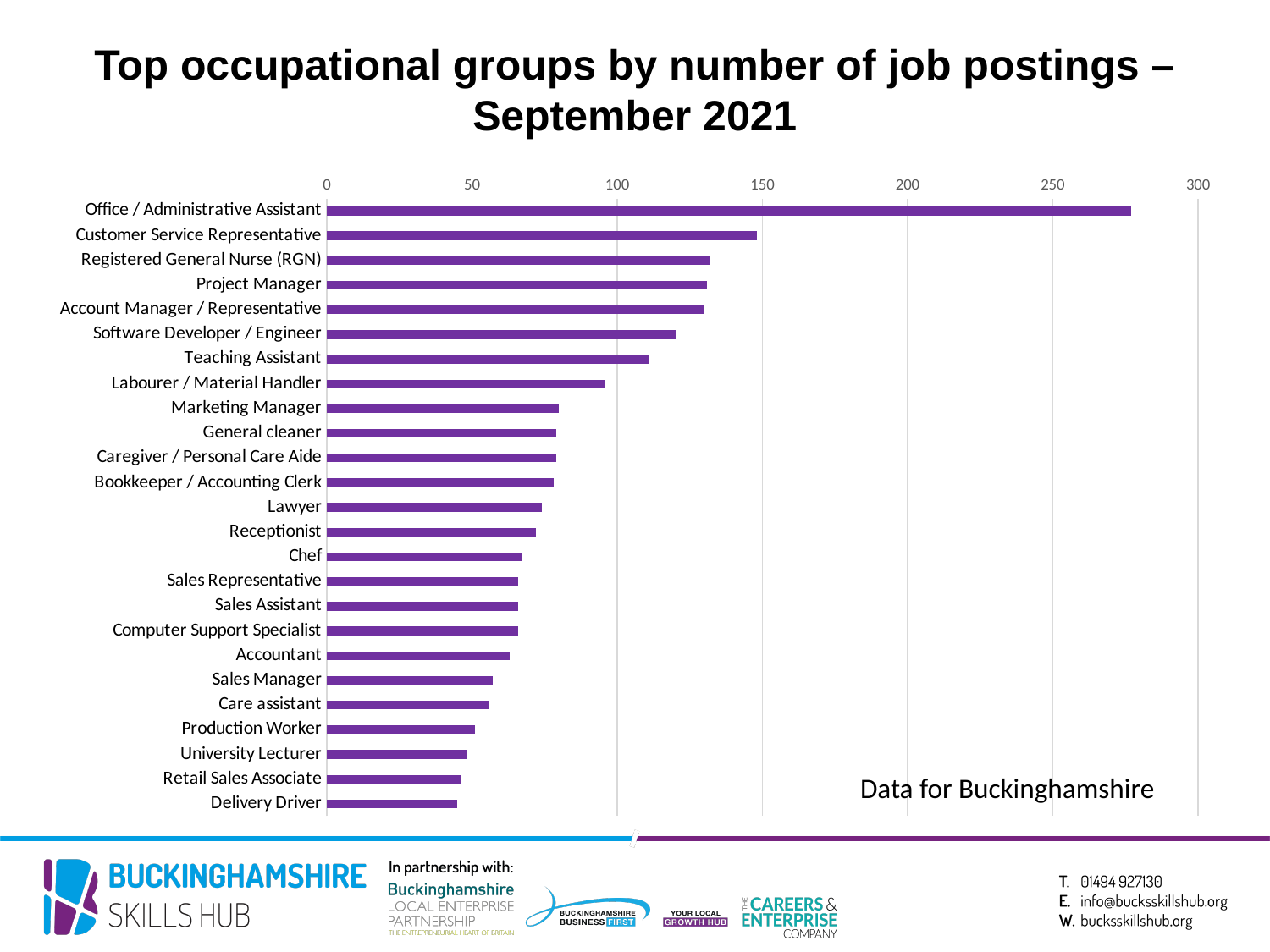
Is the value for Labourer / Material Handler greater or less than 100? less What kind of chart is shown on the slide? Bar chart Is the value for Delivery Driver greater or less than 50? less Which has more job postings, Teaching Assistant or Labourer / Material Handler? Teaching Assistant What is the title of the chart? Top occupational groups by number of job postings – September 2021 Which has more job postings, Office / Administrative Assistant or Customer Service Representative? Office / Administrative Assistant Which occupational group has the highest number of job postings? Office / Administrative Assistant Is the value for Marketing Manager greater or less than 100? less How many occupational groups are plotted in the chart? 25